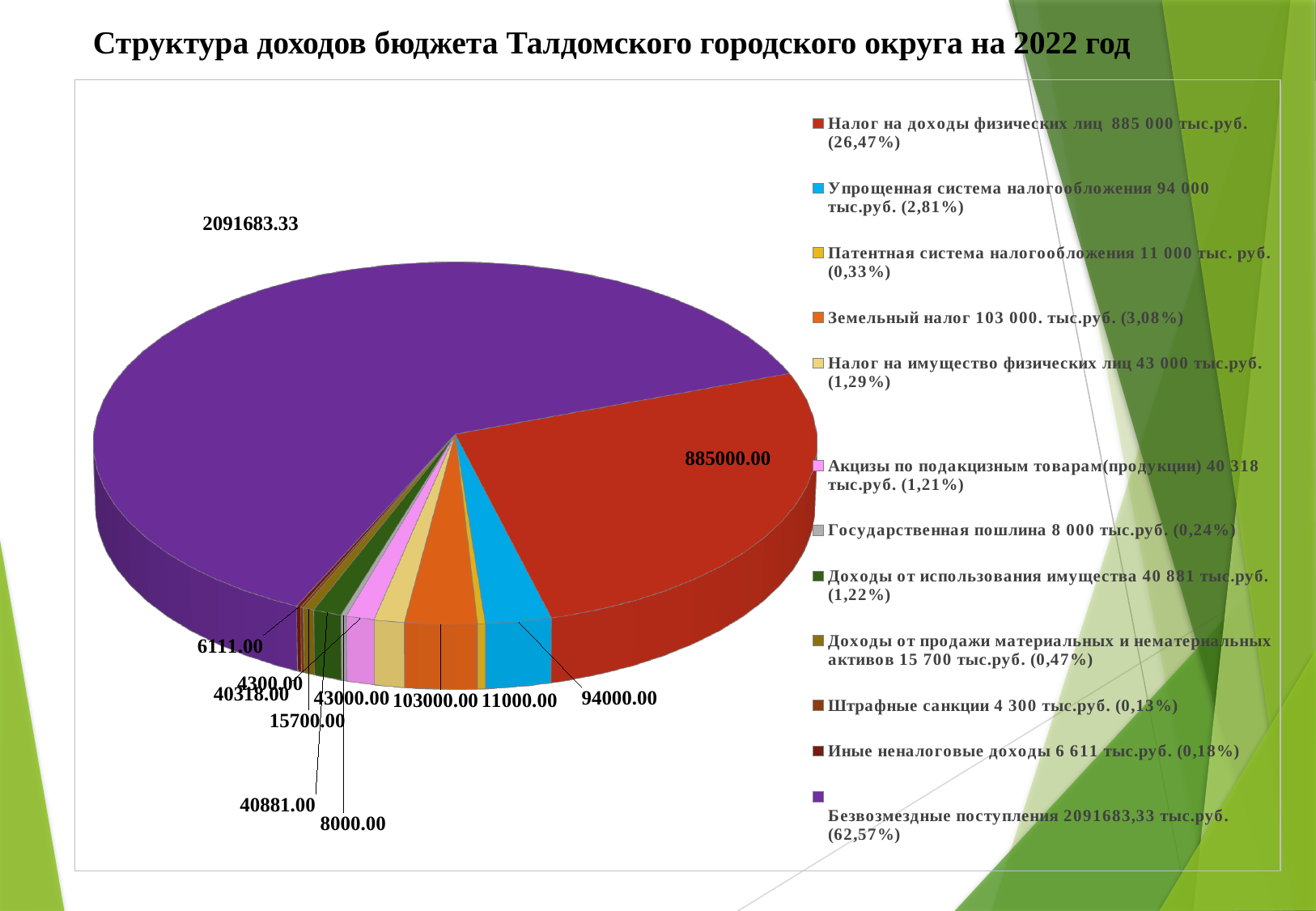
What value is labelled on the slice for Налог на доходы физических лиц? 885000.00 What share of the pie does Налог на доходы физических лиц account for, according to the legend? 26,47% Which category has the smallest slice of the pie? Штрафные санкции What kind of chart is shown on the slide? pie chart Which category has the largest slice of the pie? Безвозмездные поступления Which is larger: Упрощенная система налогообложения or Земельный налог? Земельный налог What share of the pie does Безвозмездные поступления account for, according to the legend? 62,57% What is the difference between the labelled values for Земельный налог and Упрощенная система налогообложения? 9000.00 What value is labelled on the slice for Акцизы по подакцизным товарам(продукции)? 40318.00 What value is labelled on the slice for Земельный налог? 103000.00 What is the title of the chart on the slide? Структура доходов бюджета Талдомского городского округа на 2022 год How many slices does the pie chart have? 12